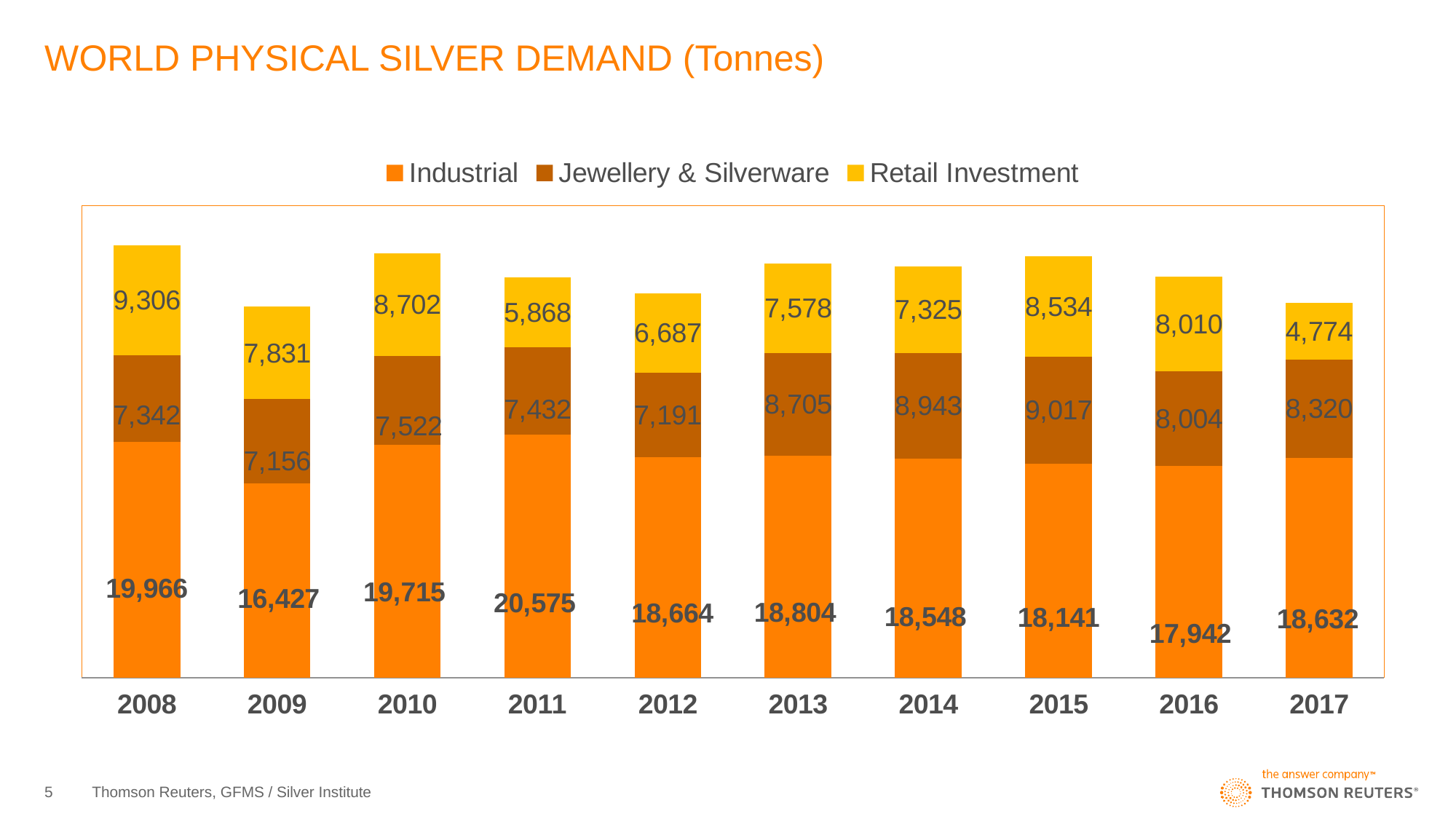
What is the Industrial demand value for 2011? 20,575 How many years are shown on the x axis? 10 What is the difference between the Industrial demand in 2011 and in 2009? 4,148 Which year has the highest Industrial demand? 2011 Which year has the highest Jewellery & Silverware demand? 2015 What is the total physical silver demand for 2008 across all three segments? 36,614 How many series does the legend list? 3 What is the Jewellery & Silverware value for 2014? 8,943 What is the Retail Investment value for 2017? 4,774 What kind of chart is shown on the slide? Stacked bar chart Which year has the lowest Retail Investment demand? 2017 Is the Retail Investment value larger in 2008 or in 2012? 2008